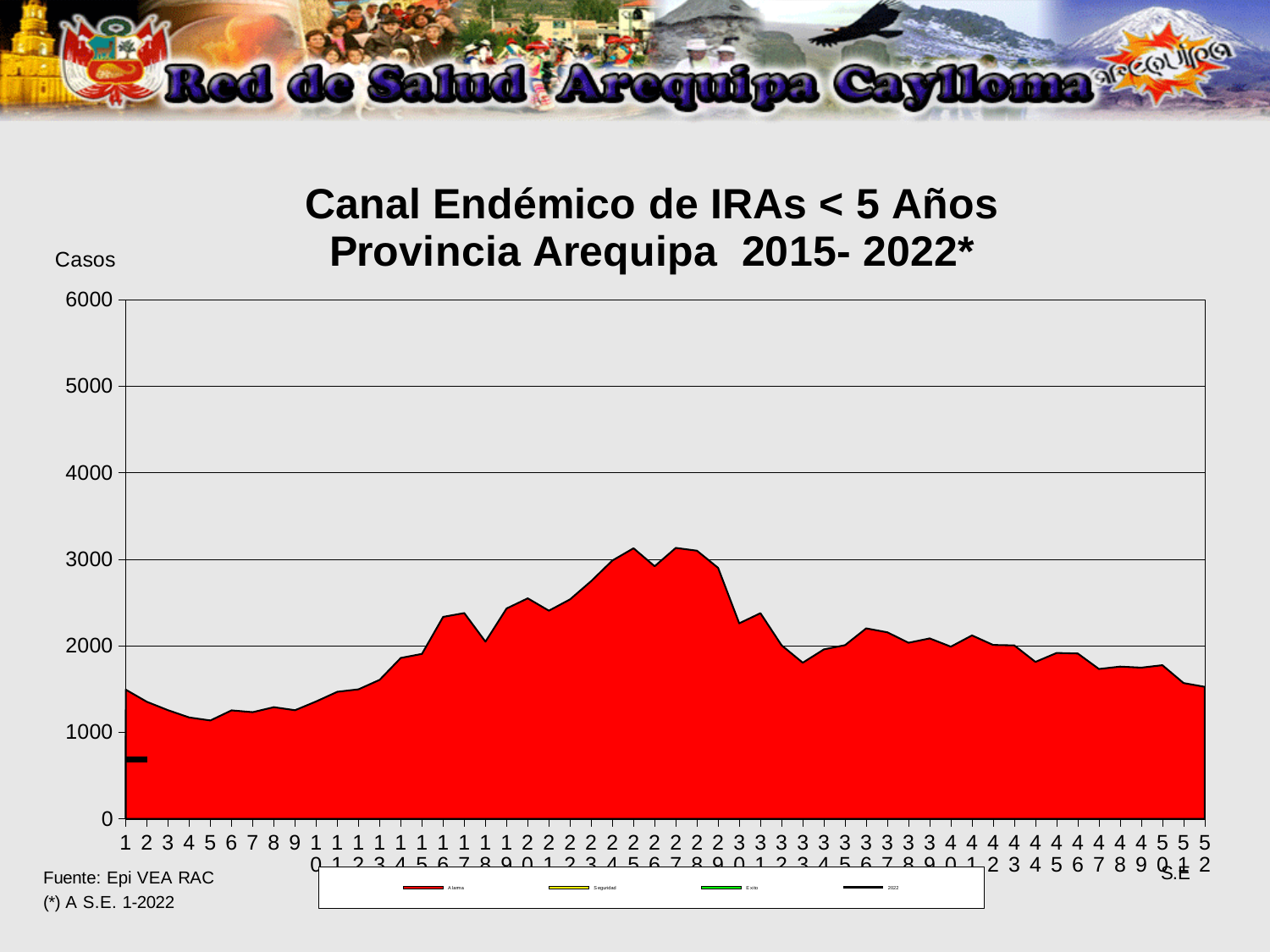
Is the Alarma value at week 1 greater or less than 1000? greater Is the Alarma value at week 25 greater or less than 2000? greater What kind of chart is shown on the slide? Area chart What is the title of the chart? Canal Endémico de IRAs < 5 Años Provincia Arequipa 2015- 2022* Does the Alarma curve rise or fall between week 10 and week 25? Rise Which is larger, the Alarma value at week 1 or at week 5? Week 1 How many epidemiological weeks are shown along the x axis? 52 Which is larger, the Alarma value at week 25 or at week 40? Week 25 What label is shown on the vertical axis of the chart? Casos Is the Alarma value at week 10 greater or less than 2000? less How many series does the chart legend list? 4